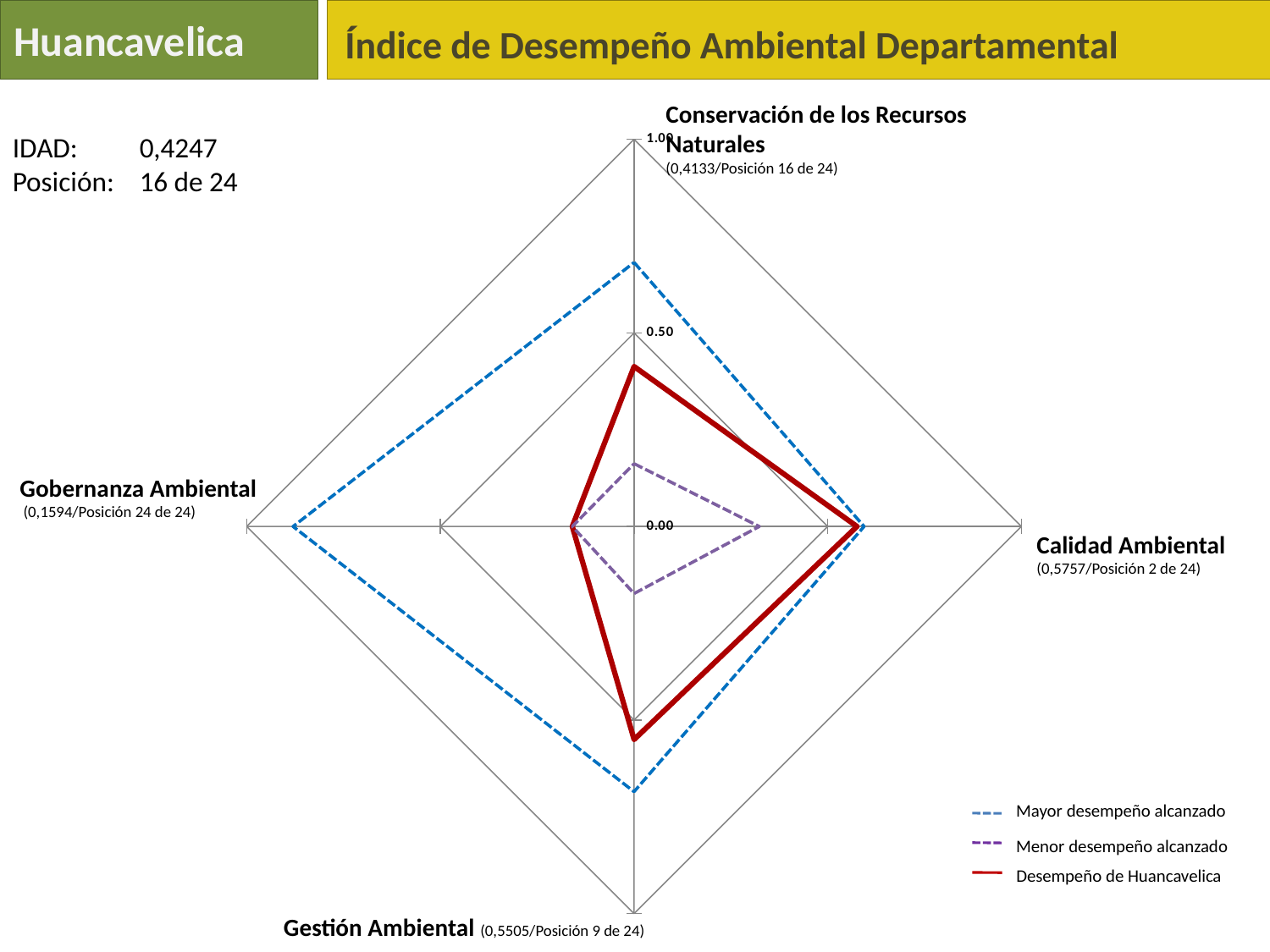
In which category does Huancavelica have its lowest value? Gobernanza Ambiental What is Huancavelica's value for Calidad Ambiental? 0,5757 How many axes (categories) does the radar chart have? 4 How many series does the legend list? 3 Which is larger for Huancavelica: Conservación de los Recursos Naturales or Gestión Ambiental? Gestión Ambiental What is Huancavelica's value for Gestión Ambiental? 0,5505 What kind of chart is shown on the slide? radar chart In which category does Huancavelica have its highest value? Calidad Ambiental Which legend entry is drawn as a solid red line? Desempeño de Huancavelica Is Huancavelica's value for Gobernanza Ambiental greater or less than 0.50? less What is Huancavelica's value for Gobernanza Ambiental? 0,1594 What is Huancavelica's value for Conservación de los Recursos Naturales? 0,4133